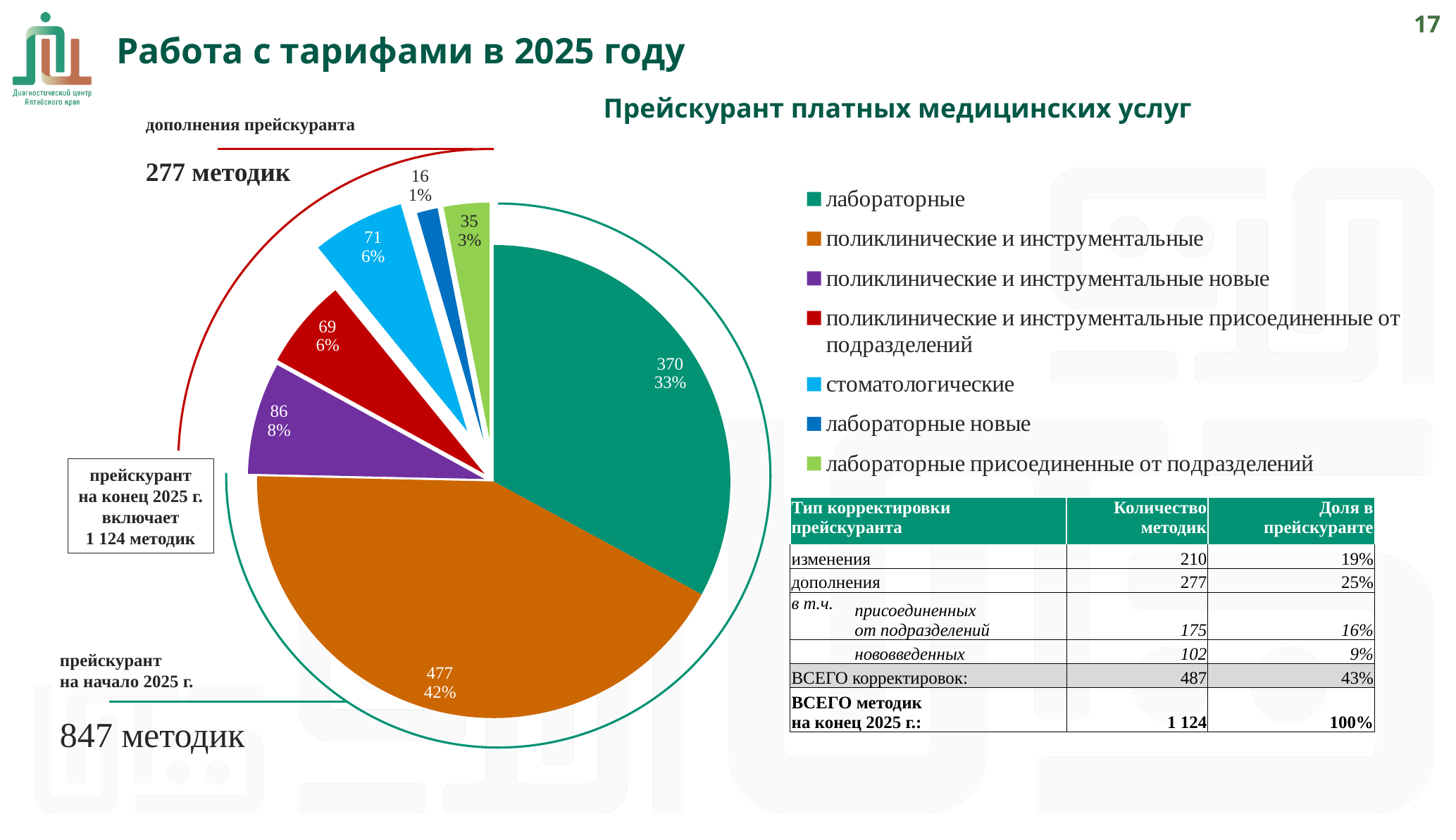
What is the value shown for the 'стоматологические' slice? 71 What is the value shown for the 'лабораторные новые' slice? 16 Which category has the smallest slice in the pie chart? лабораторные новые What type of chart is shown on the slide? pie chart What colour is the 'стоматологические' slice in the pie chart? light blue Which category has the largest slice in the pie chart? поликлинические и инструментальные Which is larger: the 'поликлинические и инструментальные новые' slice or the 'лабораторные присоединенные от подразделений' slice? поликлинические и инструментальные новые What percentage share does the 'поликлинические и инструментальные' slice have in the pie chart? 42% How many entries does the legend of the pie chart list? 7 What is the difference between the values of the 'поликлинические и инструментальные' and 'лабораторные' slices? 107 What is the value shown for the 'лабораторные' slice of the pie chart? 370 How many slices does the pie chart have? 7